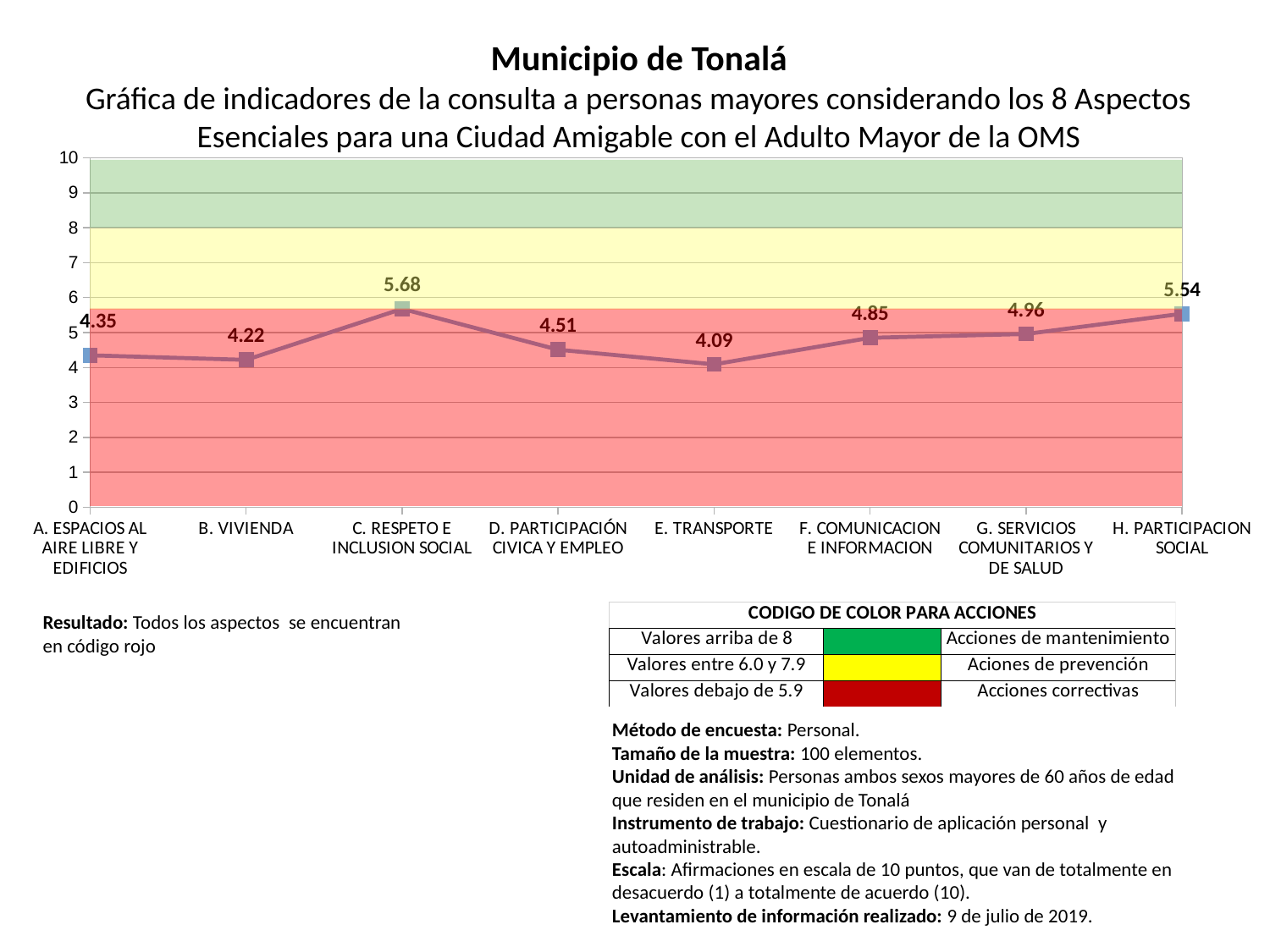
What kind of chart is shown on the slide? line chart What is the value for G. SERVICIOS COMUNITARIOS Y DE SALUD? 4.96 What is the value for C. RESPETO E INCLUSION SOCIAL? 5.68 Which aspect has the highest value? C. RESPETO E INCLUSION SOCIAL What is the difference between the values for C. RESPETO E INCLUSION SOCIAL and E. TRANSPORTE? 1.59 Which is larger, the value for A. ESPACIOS AL AIRE LIBRE Y EDIFICIOS or the value for B. VIVIENDA? A. ESPACIOS AL AIRE LIBRE Y EDIFICIOS Does the value rise or fall from D. PARTICIPACIÓN CIVICA Y EMPLEO to E. TRANSPORTE? fall Is the value for H. PARTICIPACION SOCIAL greater or less than 6? less Which aspect has the lowest value? E. TRANSPORTE What is the value for E. TRANSPORTE? 4.09 How many aspects (categories) are plotted on the x axis? 8 According to the color code table, what color band corresponds to values below 5.9? red